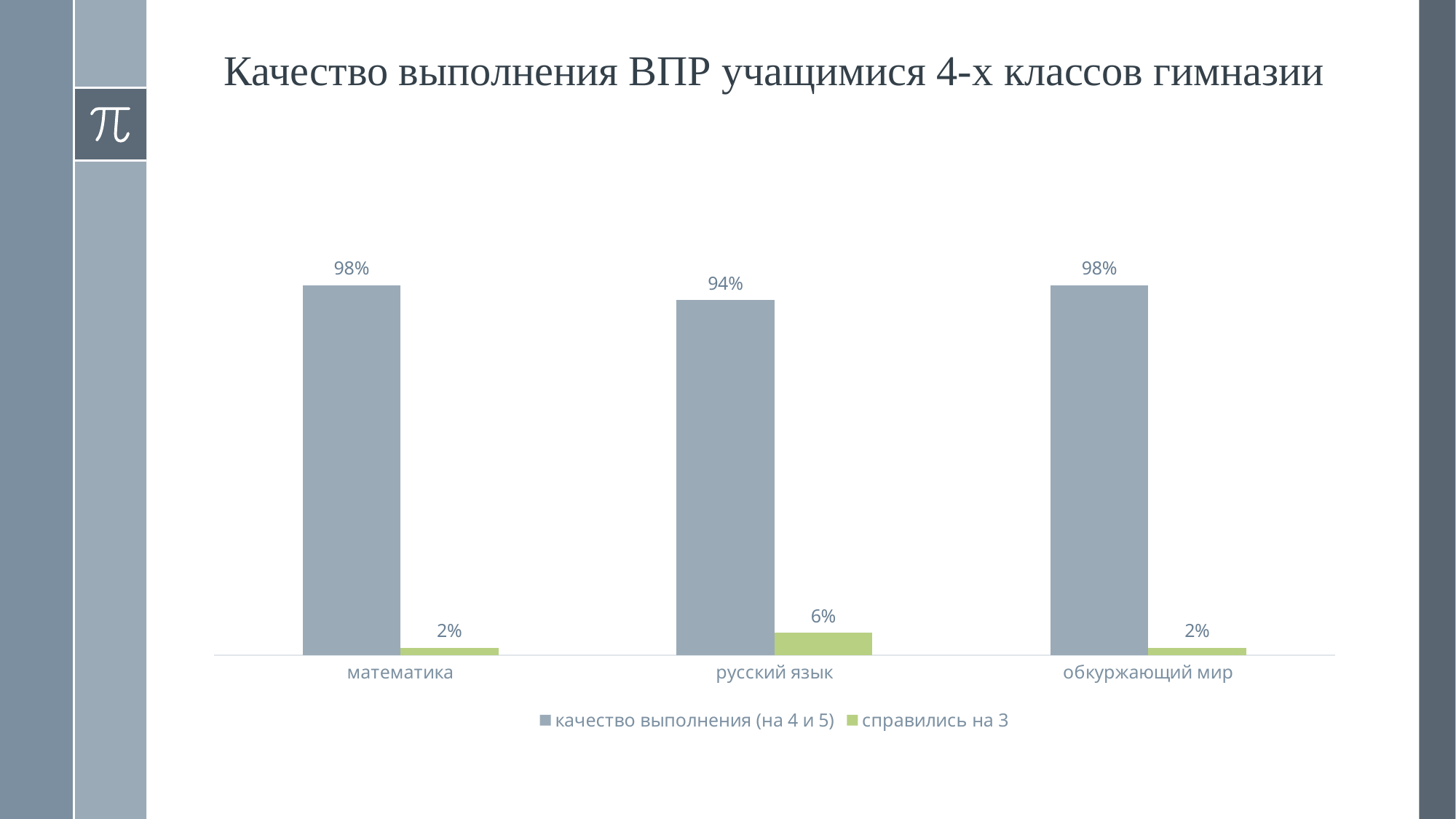
How many subjects are shown on the x axis? 3 Which subject has the highest value for "справились на 3"? русский язык What is the difference between the "качество выполнения (на 4 и 5)" values for математика and русский язык? 4% What is the value of "справились на 3" for русский язык? 6% What is the title of the slide? Качество выполнения ВПР учащимися 4-х классов гимназии What is the value of "качество выполнения (на 4 и 5)" for русский язык? 94% What is the value of "качество выполнения (на 4 и 5)" for математика? 98% How many series does the legend list? 2 What kind of chart is shown on the slide? bar chart What is the value of "справились на 3" for обкуржающий мир? 2% Which subject has the lowest value for "качество выполнения (на 4 и 5)"? русский язык Which is larger: "справились на 3" for русский язык or for математика? русский язык